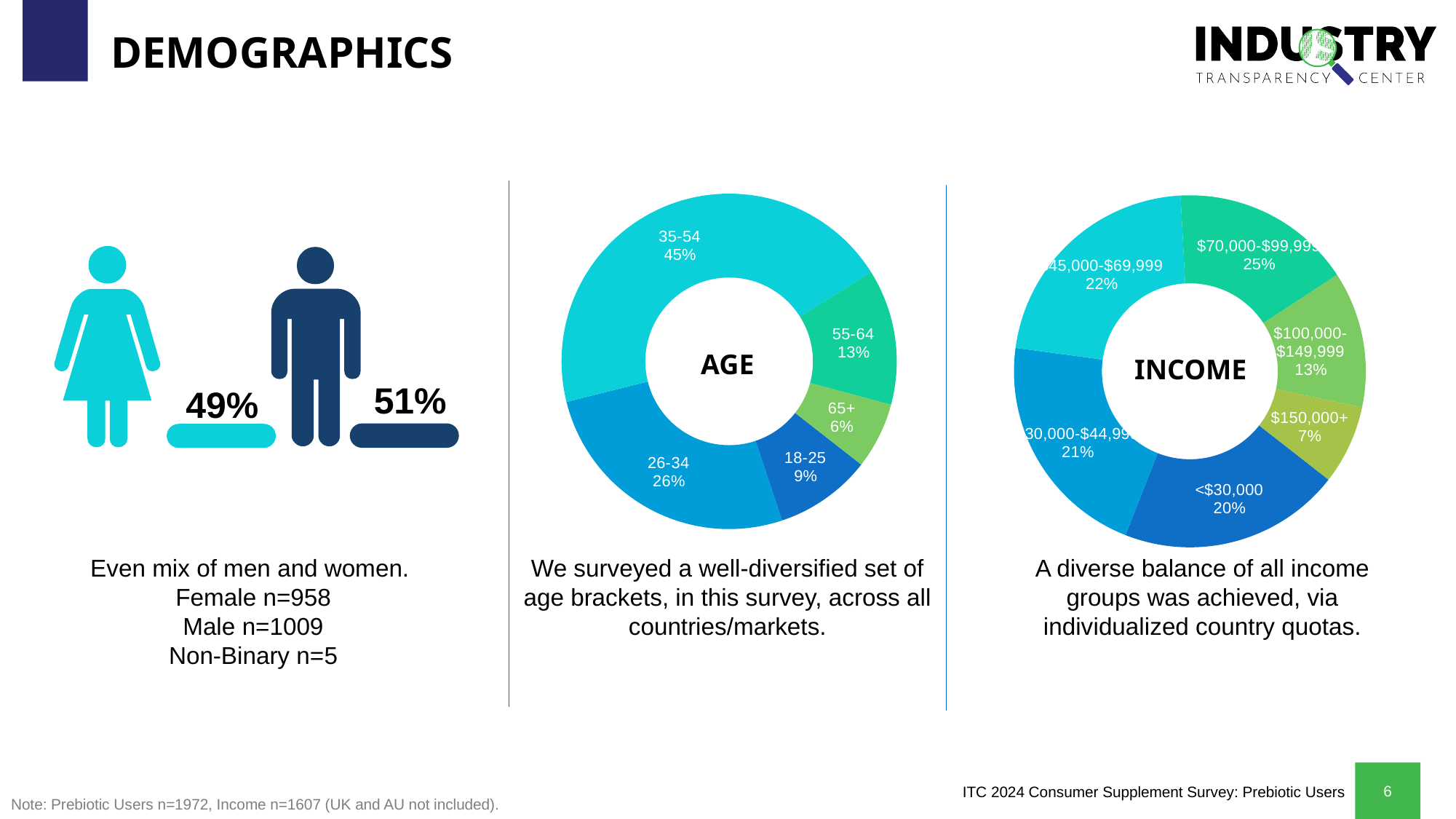
In the INCOME chart, what share of respondents earn $70,000-$99,999? 25% In the AGE chart, what percentage of respondents are aged 26-34? 26% In the AGE chart, what is the difference in percentage points between the 55-64 and 18-25 brackets? 4 How many age brackets are shown in the AGE chart? 5 In the AGE chart, which age bracket has the smallest share? 65+ What type of chart is the AGE chart? Donut (pie) chart In the AGE chart, what share of respondents are aged 35-54? 45% In the AGE chart, which age bracket has the largest share? 35-54 In the INCOME chart, what percentage of respondents earn $150,000+? 7% In the INCOME chart, which is larger: the share earning <$30,000 or the share earning $100,000-$149,999? <$30,000 How many income groups are shown in the INCOME chart? 6